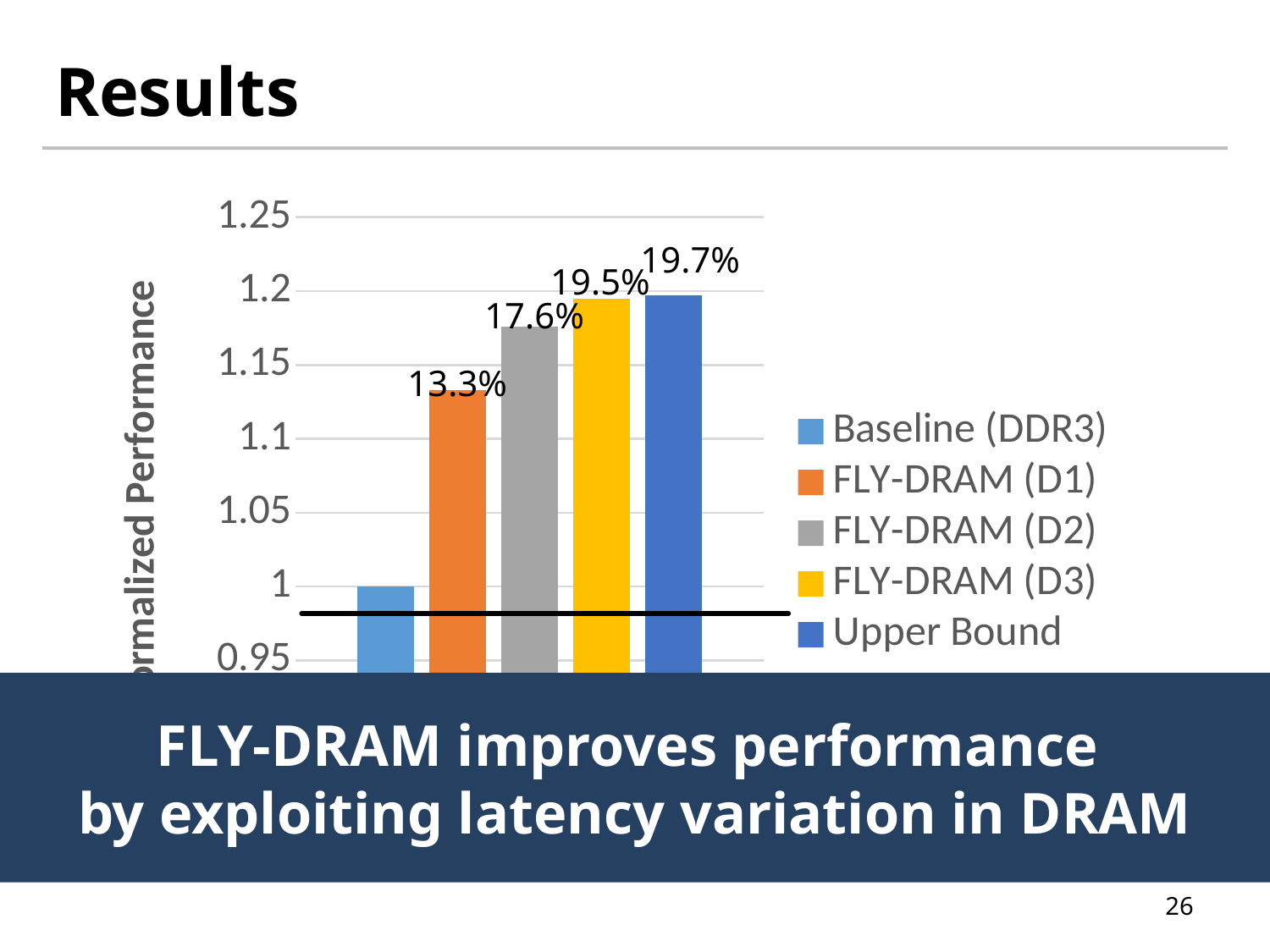
What kind of chart is shown on the slide? bar chart How many series does the legend list? 5 What percentage label is printed above the FLY-DRAM (D2) bar? 17.6% Do the bars rise or fall from left to right? rise Which series has the shortest bar? Baseline (DDR3) Which series has the tallest bar? Upper Bound What percentage label is printed above the Upper Bound bar? 19.7% What percentage label is printed above the FLY-DRAM (D3) bar? 19.5% Which bar is taller, FLY-DRAM (D1) or FLY-DRAM (D2)? FLY-DRAM (D2) Is the bar for Baseline (DDR3) greater or less than 1.1? less What percentage label is printed above the FLY-DRAM (D1) bar? 13.3% Is the bar for FLY-DRAM (D3) greater or less than 1.15? greater